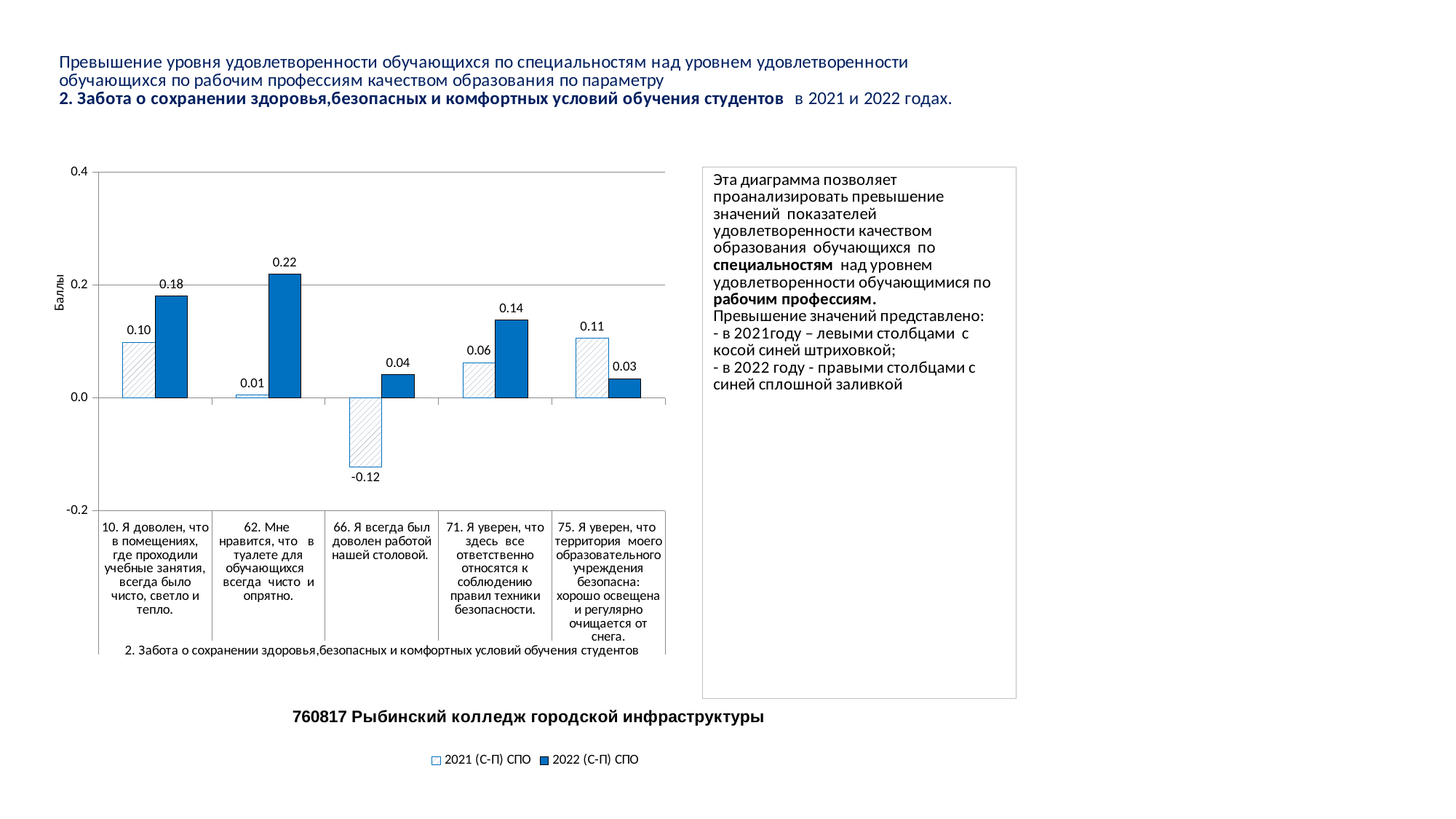
For category 75, which series has the larger value: 2021 (С-П) СПО or 2022 (С-П) СПО? 2021 (С-П) СПО Which category has the lowest 2021 (С-П) СПО value? 66. Я всегда был доволен работой нашей столовой. What is the 2021 (С-П) СПО value for category 66 (Я всегда был доволен работой нашей столовой)? -0.12 What type of chart is shown on the slide? Bar chart What is the label of the vertical axis of the chart? Баллы What is the 2022 (С-П) СПО value for category 62 (Мне нравится, что в туалете для обучающихся всегда чисто и опрятно)? 0.22 What is the difference between the 2022 and 2021 (С-П) СПО values for category 62? 0.21 How many categories are shown on the x axis of the chart? 5 How many series does the chart legend list? 2 What is the 2021 (С-П) СПО value for category 10 (Я доволен, что в помещениях, где проходили учебные занятия, всегда было чисто, светло и тепло)? 0.10 Which category has the highest 2022 (С-П) СПО value? 62. Мне нравится, что в туалете для обучающихся всегда чисто и опрятно. What is the 2022 (С-П) СПО value for category 75 (Я уверен, что территория моего образовательного учреждения безопасна)? 0.03